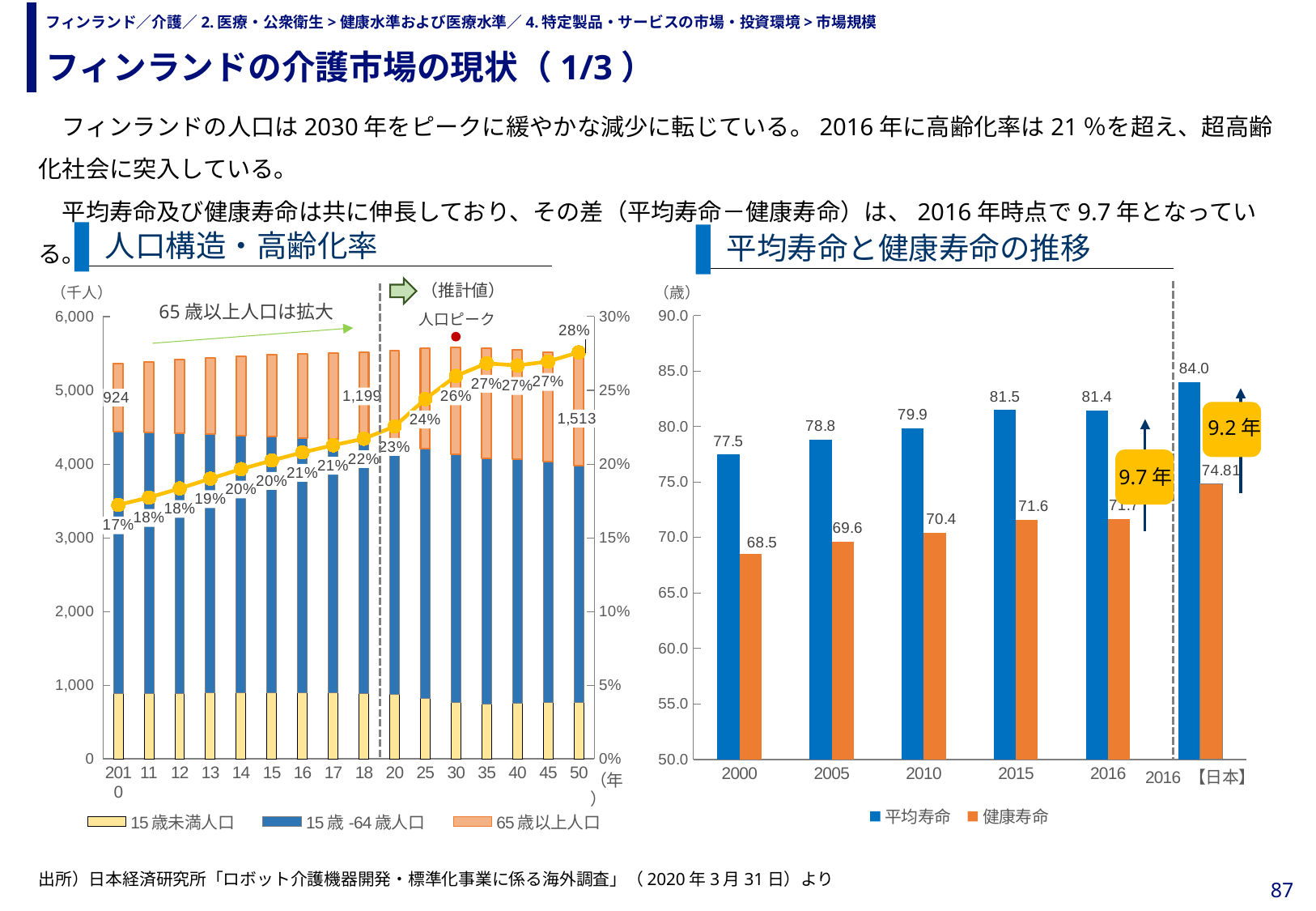
In the right chart (平均寿命と健康寿命の推移), what is the difference between 平均寿命 and 健康寿命 in 2016 for Finland? 9.7 What kind of chart is the right chart (平均寿命と健康寿命の推移)? Bar chart In the left chart (人口構造・高齢化率), what is the 高齢化率 percentage shown for 2050? 28% In the right chart (平均寿命と健康寿命の推移), what is the 健康寿命 value for 2015? 71.6 In the right chart (平均寿命と健康寿命の推移), which category has the highest 平均寿命 value? 2016【日本】 In the left chart (人口構造・高齢化率), what is the 65歳以上人口 value for 2018? 1,199 In the left chart (人口構造・高齢化率), does the 高齢化率 line rise or fall from 2010 to 2050? Rises In the right chart (平均寿命と健康寿命の推移), how many series does the legend list? 2 In the left chart (人口構造・高齢化率), what is the 65歳以上人口 value for 2010? 924 In the left chart (人口構造・高齢化率), how many series does the legend list? 3 In the right chart (平均寿命と健康寿命の推移), what is the 平均寿命 value for 2000? 77.5 In the right chart (平均寿命と健康寿命の推移), which is larger: 平均寿命 in 2005 or 平均寿命 in 2010? 2010